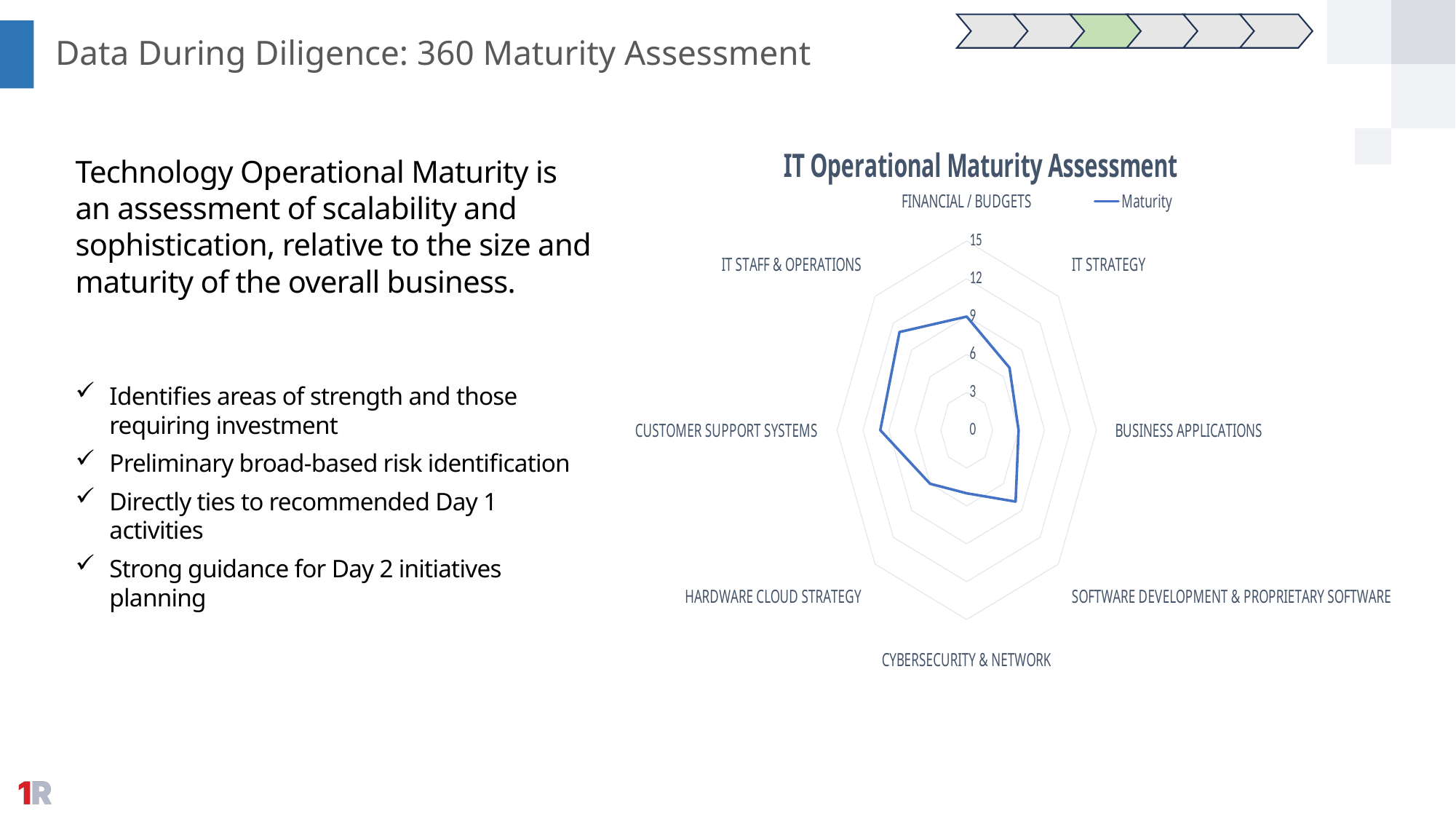
Which category has the lowest Maturity value? Cybersecurity & Network Is the Maturity value for Financial / Budgets greater or less than 6? greater How many categories (axes) does the radar chart have? 8 What kind of chart is shown on the slide? Radar chart How many series does the chart legend list? 1 What is the name of the series shown in the legend? Maturity Which has a higher Maturity value, IT Staff & Operations or Business Applications? IT Staff & Operations What is the maximum value shown on the chart's axis scale? 15 Which has a higher Maturity value, Financial / Budgets or Hardware Cloud Strategy? Financial / Budgets What is the title of the chart? IT Operational Maturity Assessment Is the Maturity value for IT Staff & Operations greater or less than 6? greater